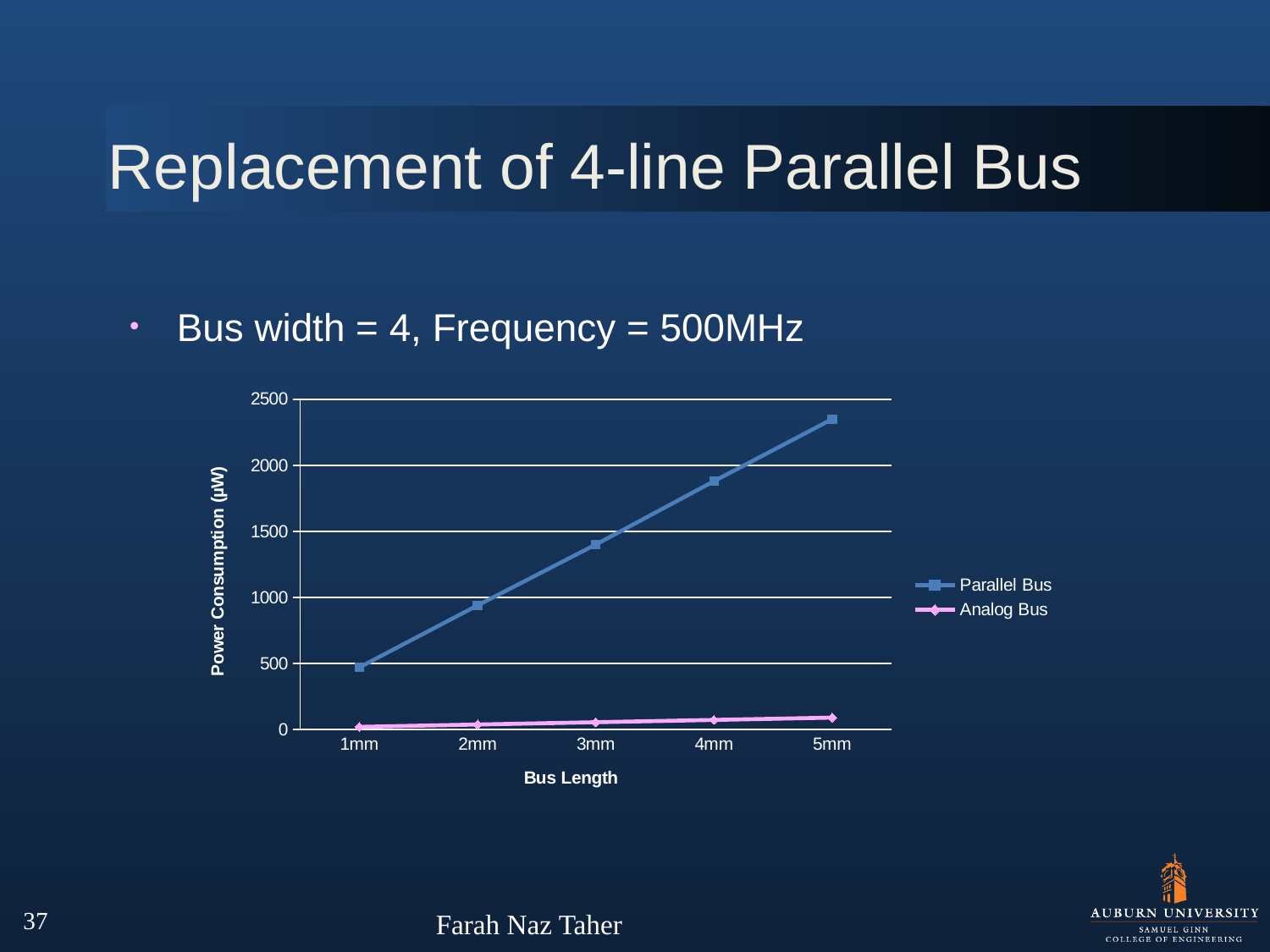
Does the Parallel Bus power consumption rise or fall as bus length increases from 1mm to 5mm? rise Is the Parallel Bus value at 5mm greater or less than 2000? greater Which series has the higher power consumption at 5mm, Parallel Bus or Analog Bus? Parallel Bus At which bus length is the Parallel Bus power consumption lowest? 1mm What is the label of the x axis? Bus Length How many bus length categories are plotted on the x axis? 5 What is the label of the y axis? Power Consumption (µW) What kind of chart is shown on the slide? line chart At which bus length is the Parallel Bus power consumption highest? 5mm How many series does the legend list? 2 Is the Parallel Bus value at 4mm greater or less than 1500? greater Is the Analog Bus value at 5mm greater or less than 500? less